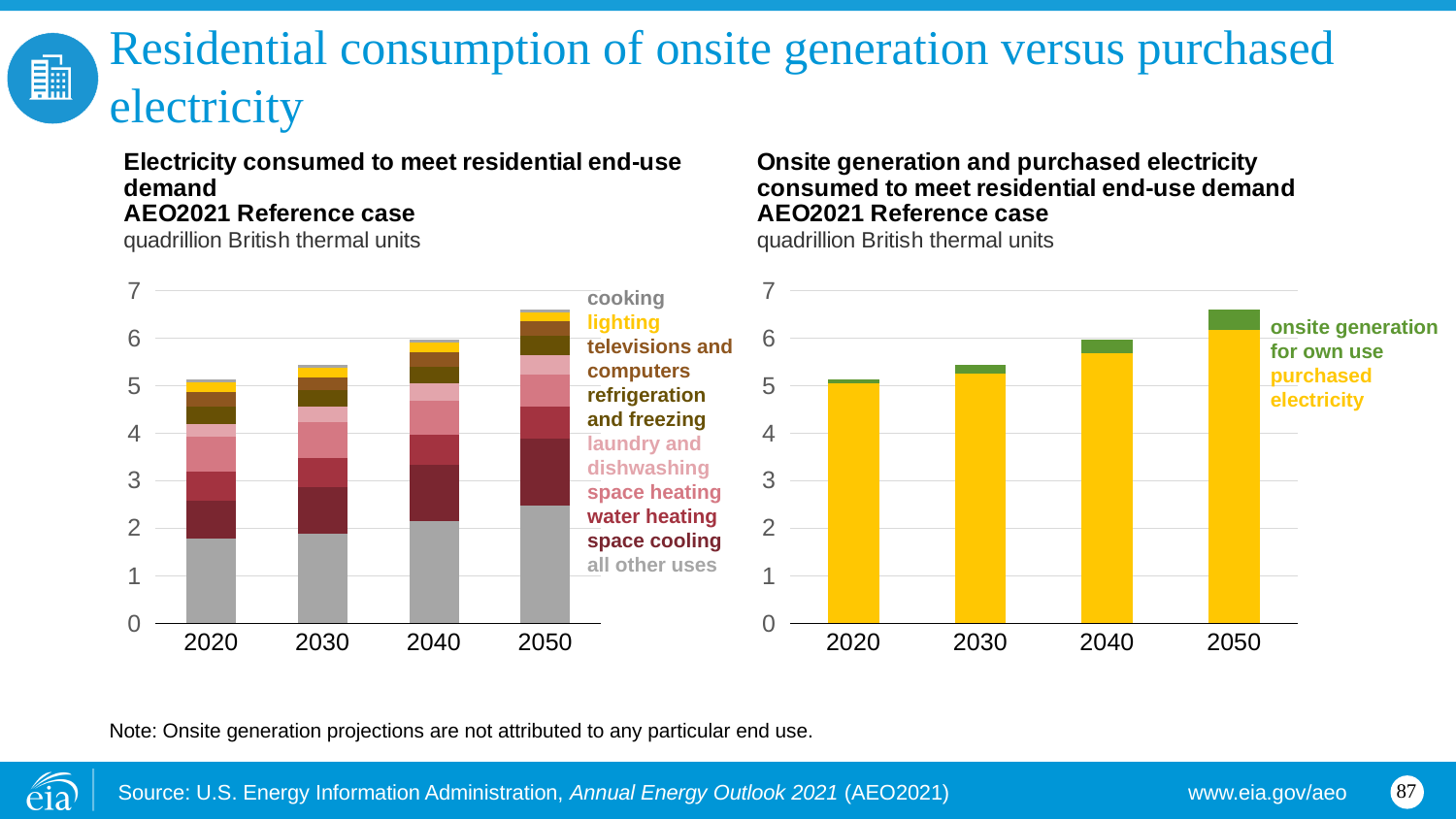
What kind of chart is the left chart, 'Electricity consumed to meet residential end-use demand'? stacked bar chart In the left chart, 'Electricity consumed to meet residential end-use demand', do the total bar heights rise or fall from 2020 to 2050? rise In the left chart, 'Electricity consumed to meet residential end-use demand', which year has the tallest total bar? 2050 How many years are shown on the x axis of the right chart, 'Onsite generation and purchased electricity consumed to meet residential end-use demand'? 4 In the right chart, 'Onsite generation and purchased electricity consumed to meet residential end-use demand', is the total bar for 2050 greater or less than 6? greater How many end-use series does the legend of the left chart, 'Electricity consumed to meet residential end-use demand', list? 9 In the right chart, 'Onsite generation and purchased electricity consumed to meet residential end-use demand', which year has the shortest total bar? 2020 In the left chart, 'Electricity consumed to meet residential end-use demand', is the total bar for 2050 greater or less than 6? greater What unit is used on the y axis of both charts? quadrillion British thermal units In the left chart, 'Electricity consumed to meet residential end-use demand', is the total bar for 2020 greater or less than 6? less How many series does the legend of the right chart, 'Onsite generation and purchased electricity consumed to meet residential end-use demand', list? 2 In the right chart, 'Onsite generation and purchased electricity consumed to meet residential end-use demand', which series is shown in green? onsite generation for own use